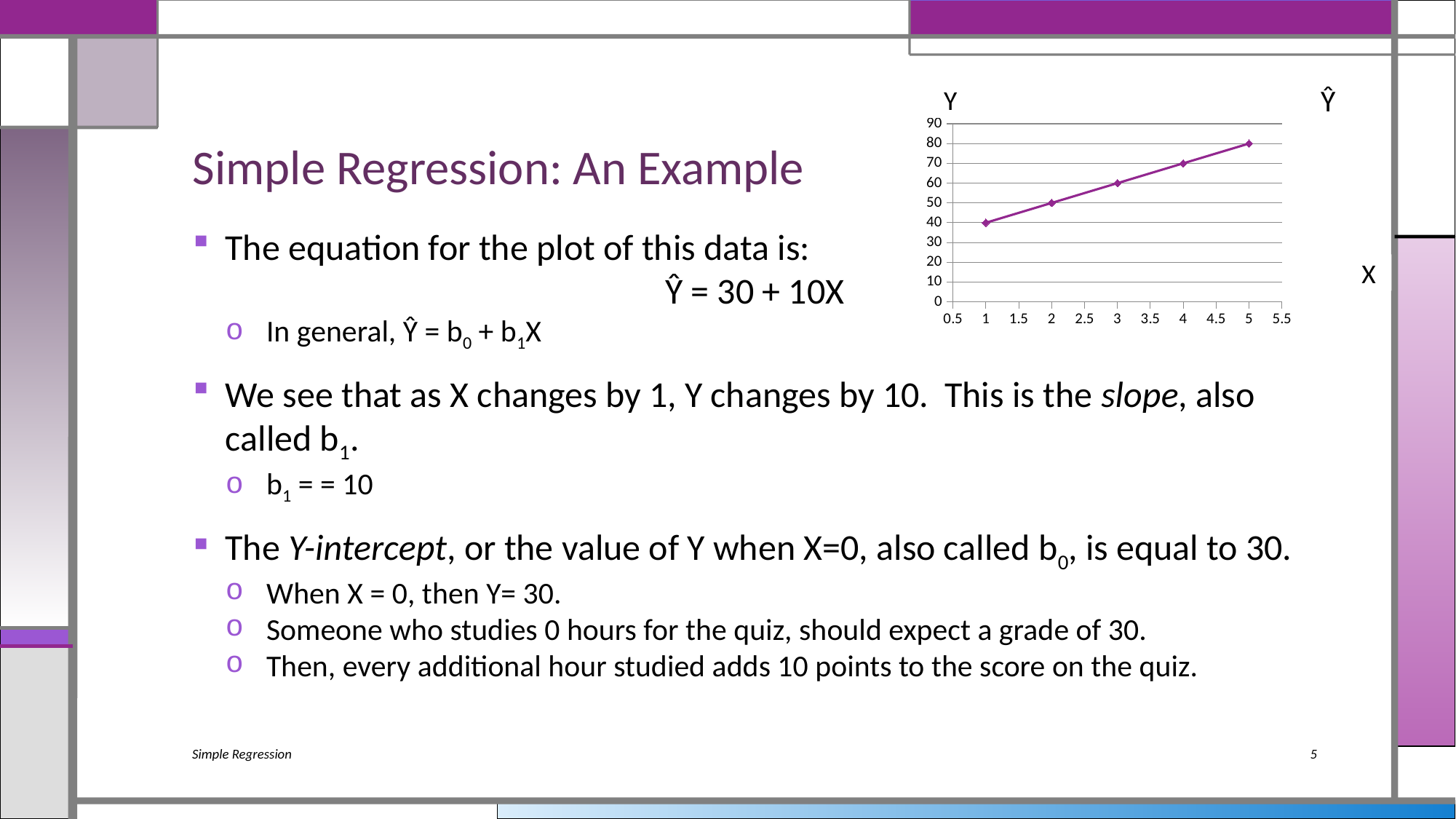
How many data points are plotted on the chart? 5 At which X value is the plotted Y value lowest? 1 What is the difference between the Y value at X = 5 and the Y value at X = 1? 40 What is the Y value of the plotted point at X = 1? 40 What is the Y value of the plotted point at X = 3? 60 What is the highest tick value shown on the vertical axis of the chart? 90 At which X value is the plotted Y value highest? 5 Which has the larger Y value: the point at X = 4 or the point at X = 2? X = 4 What kind of chart is shown on the slide? line chart What is the Y value of the plotted point at X = 5? 80 Is the Y value at X = 2 greater or less than 60? less Do the plotted Y values rise or fall as X increases? rise